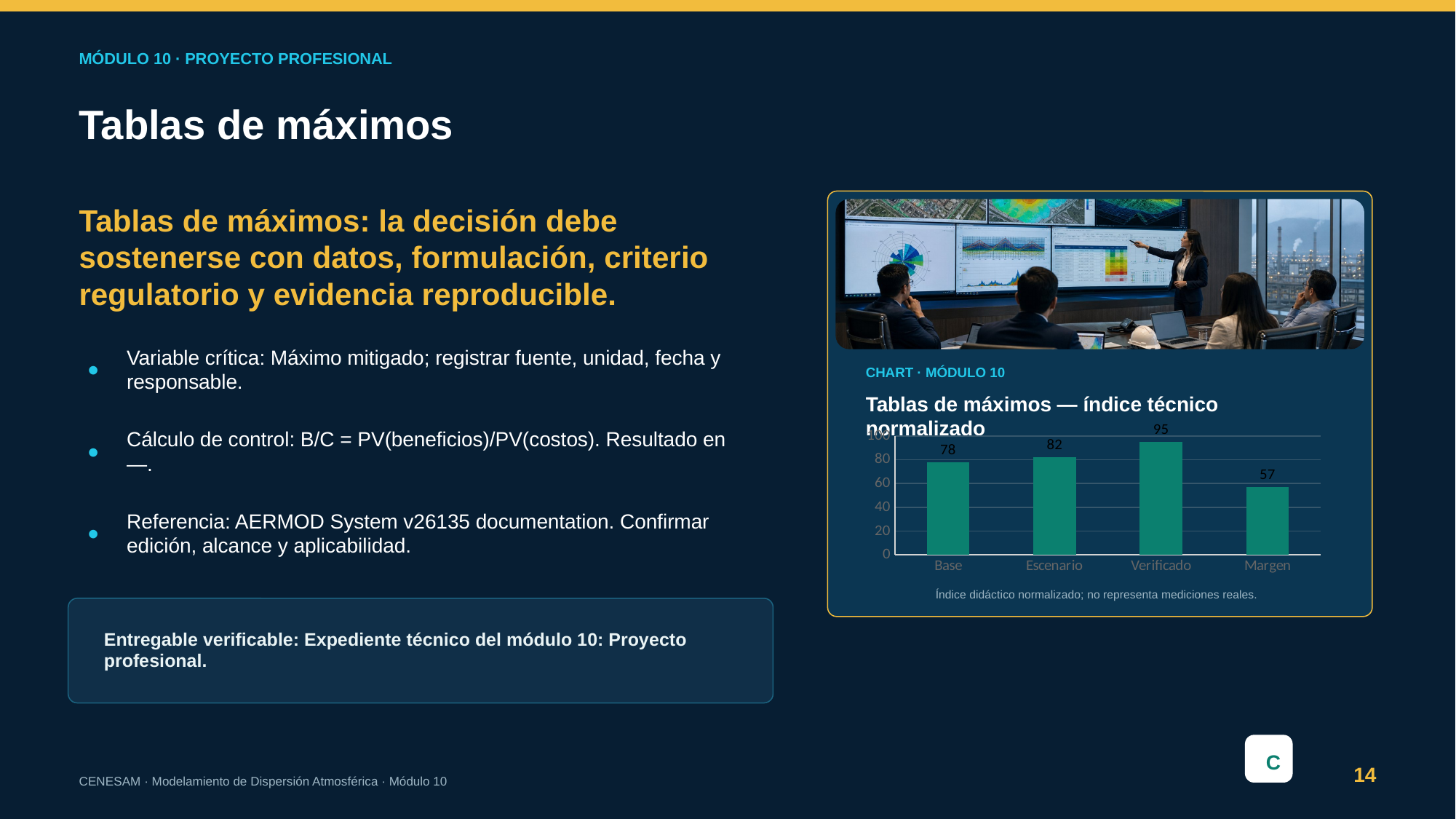
What is the value for Escenario? 82 How many categories are shown on the x axis? 4 What is the value for Margen? 57 Which category has the highest value? Verificado What is the value for Verificado? 95 Which is larger, the value for Base or the value for Margen? Base What is the difference between the values for Verificado and Margen? 38 What is the value for Base? 78 What is the title of the chart? Tablas de máximos — índice técnico normalizado Which category has the lowest value? Margen What is the difference between the values for Escenario and Base? 4 What kind of chart is shown? Bar chart